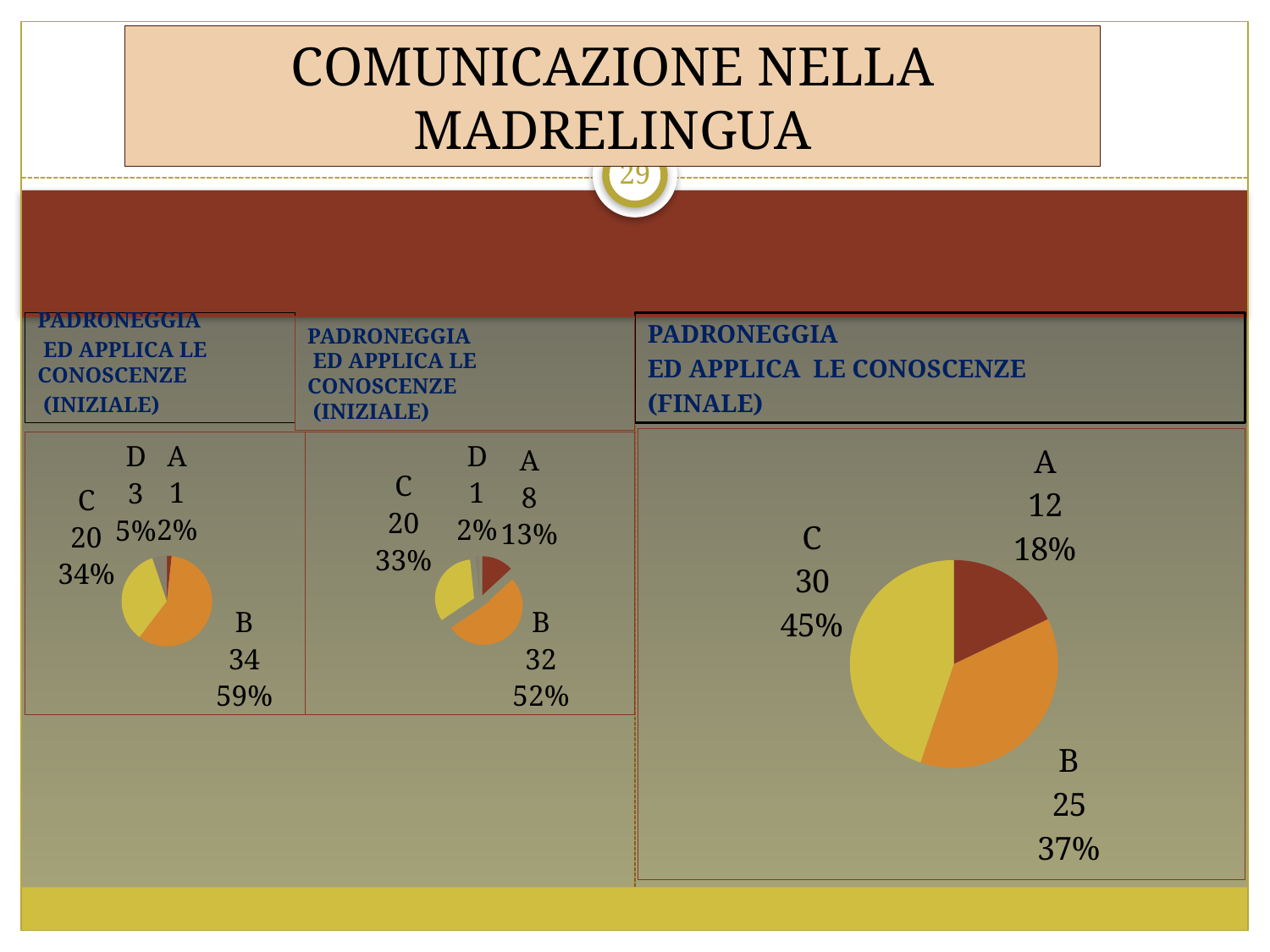
In the rightmost pie chart (FINALE), what is the value for category C? 30 In the rightmost pie chart (FINALE), what is the difference between the values for C and B? 5 In the leftmost pie chart (INIZIALE), what share of the pie does category C represent? 34% In the rightmost pie chart (FINALE), what share of the pie does category A represent? 18% In the rightmost pie chart (FINALE), which category has the smallest value? A In the leftmost pie chart (INIZIALE), what is the value for category B? 34 In the middle pie chart (INIZIALE), which is larger, the value for B or the value for C? B How many categories are shown in the rightmost pie chart (FINALE)? 3 In the rightmost pie chart (FINALE), which category has the largest value? C What type of chart is the rightmost chart (FINALE)? Pie chart In the middle pie chart (INIZIALE), what is the value for category A? 8 In the leftmost pie chart (INIZIALE), which category has the smallest value? A